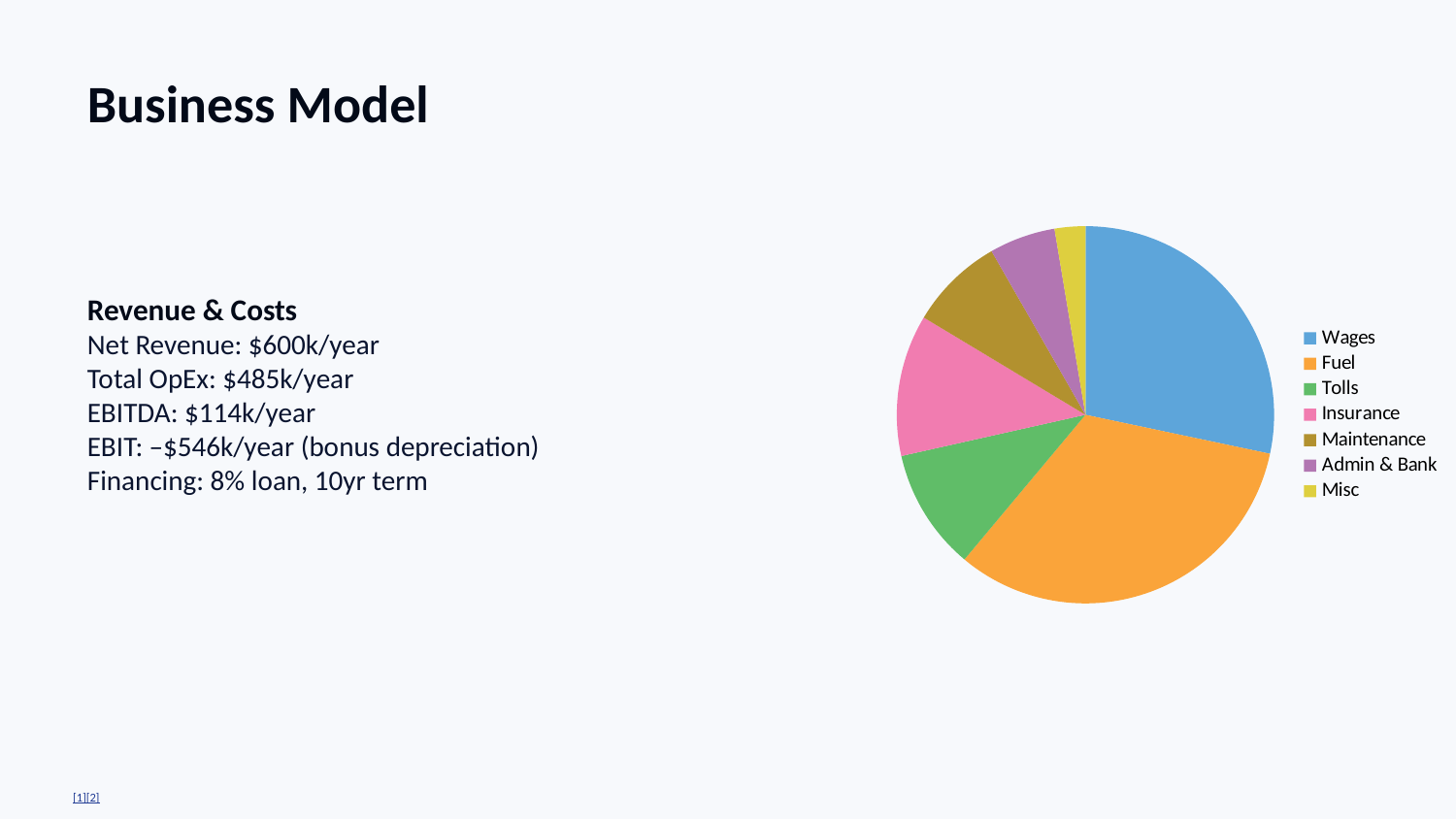
Which category has the smallest slice in the pie chart? Misc What colour represents Fuel in the pie chart? orange Which slice is larger in the pie chart, Insurance or Misc? Insurance Which slice is larger in the pie chart, Tolls or Misc? Tolls What kind of chart is shown on the slide? pie chart Which category has the largest slice in the pie chart? Fuel How many categories does the pie chart's legend list? 7 Which category is shown in blue in the pie chart? Wages Which slice is larger in the pie chart, Wages or Tolls? Wages